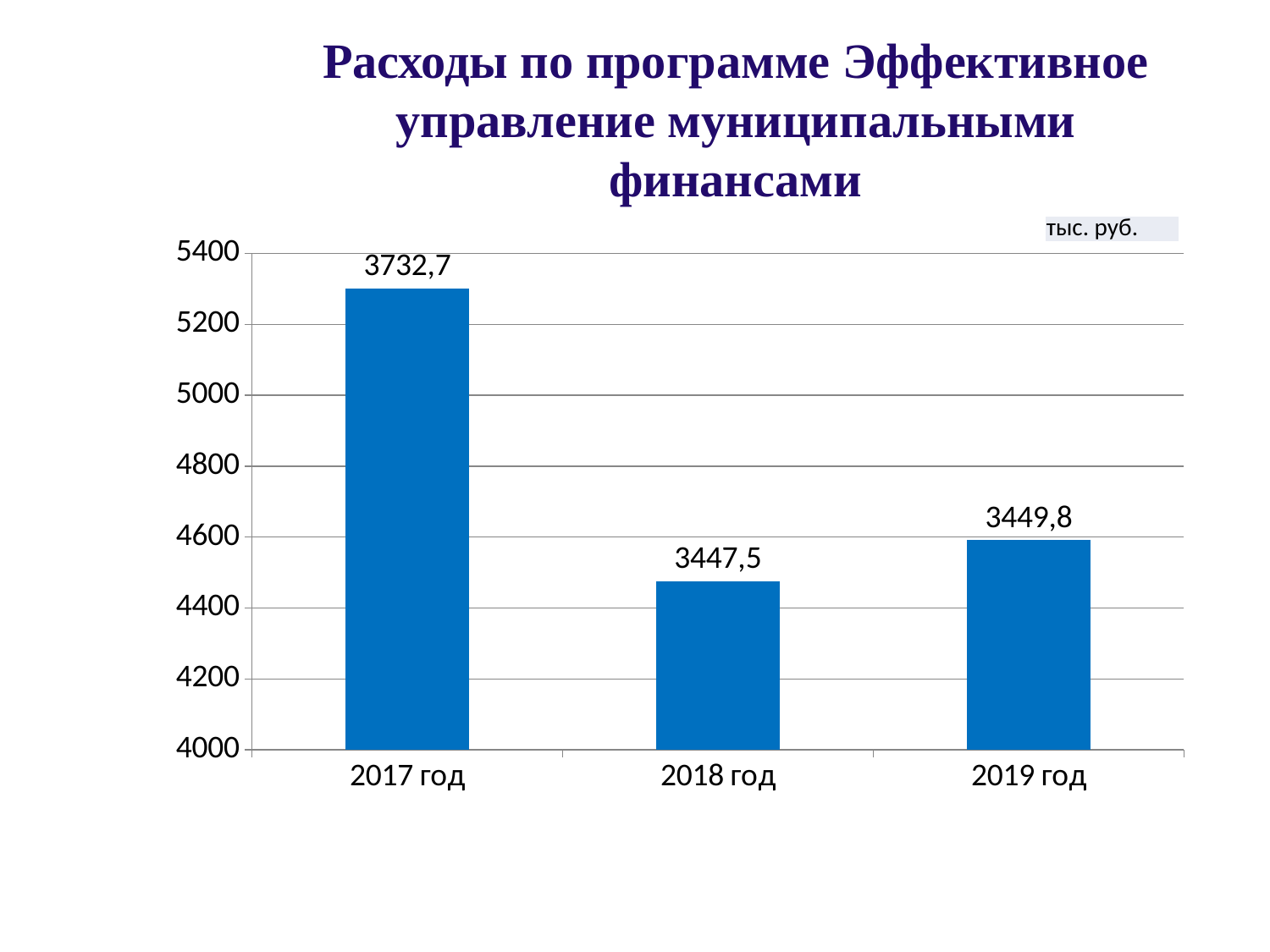
What is the value for 2018 год? 3447,5 What is the value for 2019 год? 3449,8 Which year has the highest value? 2017 год How many years are shown on the chart? 3 What is the value for 2017 год? 3732,7 Which is larger, the value for 2017 год or the value for 2019 год? 2017 год Does the value rise or fall from 2017 год to 2018 год? fall What is the difference between the values for 2019 год and 2018 год? 2,3 What is the difference between the values for 2017 год and 2018 год? 285,2 Which year has the lowest value? 2018 год What unit is indicated in the label at the top right of the chart? тыс. руб. What kind of chart is shown on the slide? bar chart